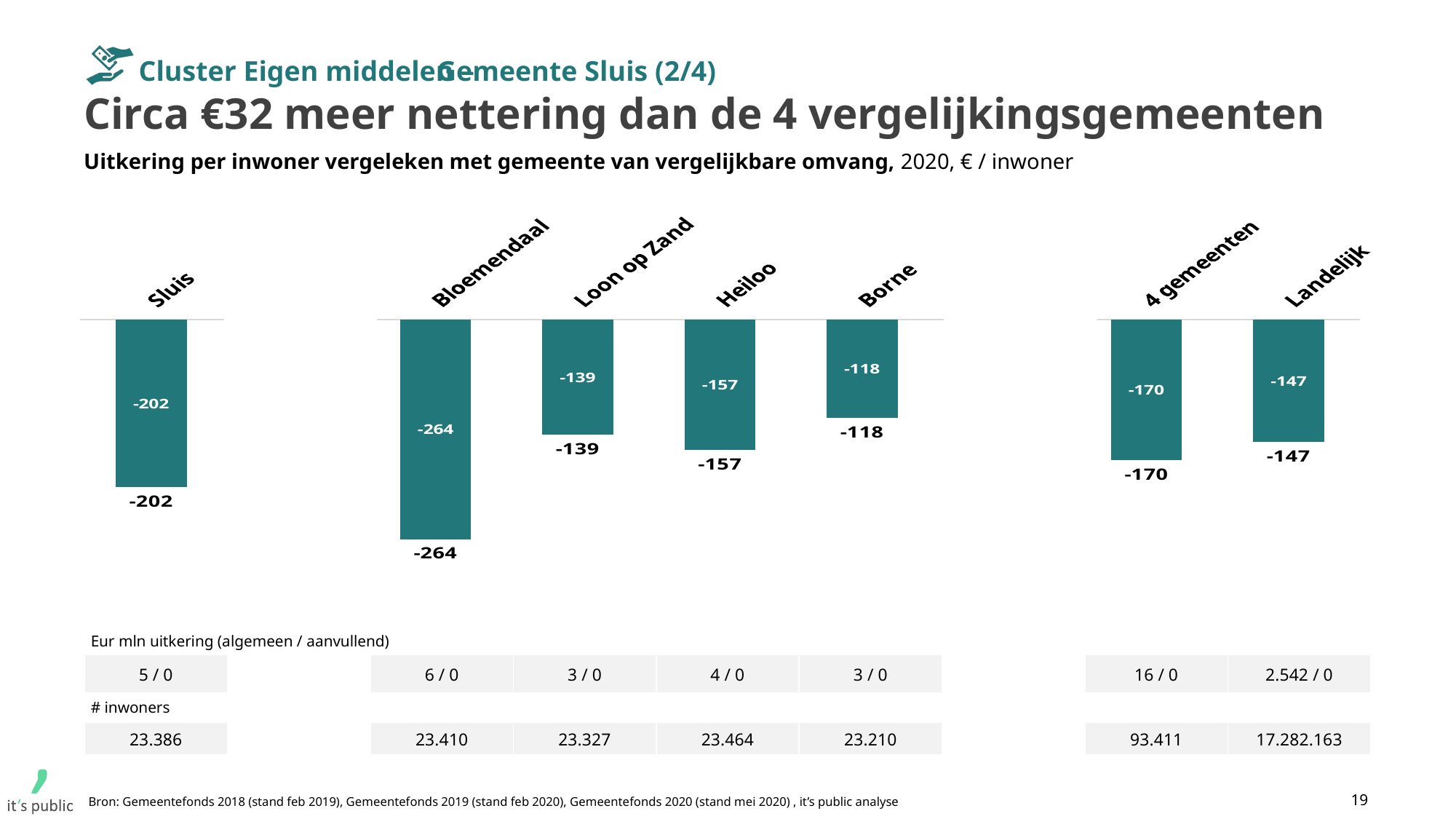
What is the value for Bloemendaal in the chart? -264 Which category has the lowest (most negative) value in the chart? Bloemendaal What is the value for 4 gemeenten in the chart? -170 What is the value for Landelijk in the chart? -147 Which has the higher value, Heiloo or Loon op Zand? Loon op Zand Which category has the highest (least negative) value in the chart? Borne What kind of chart is shown on the slide? Bar chart What is the difference between the values for Bloemendaal and Borne? 146 What unit is stated in the chart subtitle for the values? € / inwoner How many bars are plotted in the chart? 7 What is the value for Sluis in the chart? -202 What is the difference between the values for Sluis and 4 gemeenten? 32